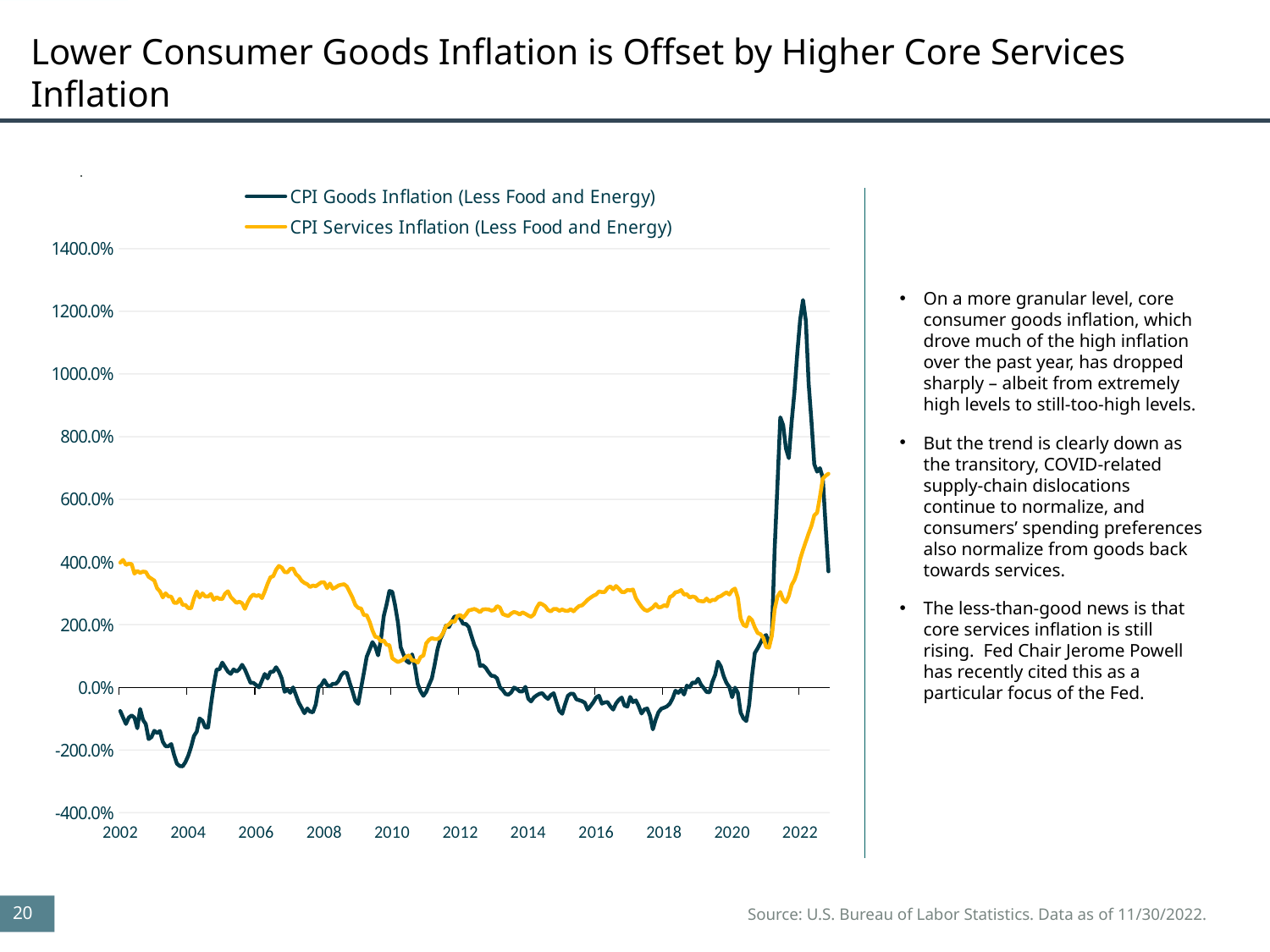
Is the value of CPI Services Inflation (Less Food and Energy) around 2010 greater or less than 200.0%? less In 2016, which series has the higher value: CPI Goods Inflation or CPI Services Inflation? CPI Services Inflation (Less Food and Energy) What are the two series named in the chart's legend? CPI Goods Inflation (Less Food and Energy) and CPI Services Inflation (Less Food and Energy) How many year labels are shown on the x axis? 11 Is the value of CPI Goods Inflation (Less Food and Energy) in 2004 greater or less than 0.0%? less At the 2022 peak, which series has the higher value: CPI Goods Inflation or CPI Services Inflation? CPI Goods Inflation (Less Food and Energy) How many series does the chart's legend list? 2 Which colour is used for the CPI Services Inflation (Less Food and Energy) line? Yellow Does CPI Services Inflation (Less Food and Energy) rise or fall between 2020 and the end of 2022? Rise Is the peak value of CPI Goods Inflation (Less Food and Energy) around 2022 greater or less than 1000.0%? greater What kind of chart is shown on the slide? Line chart